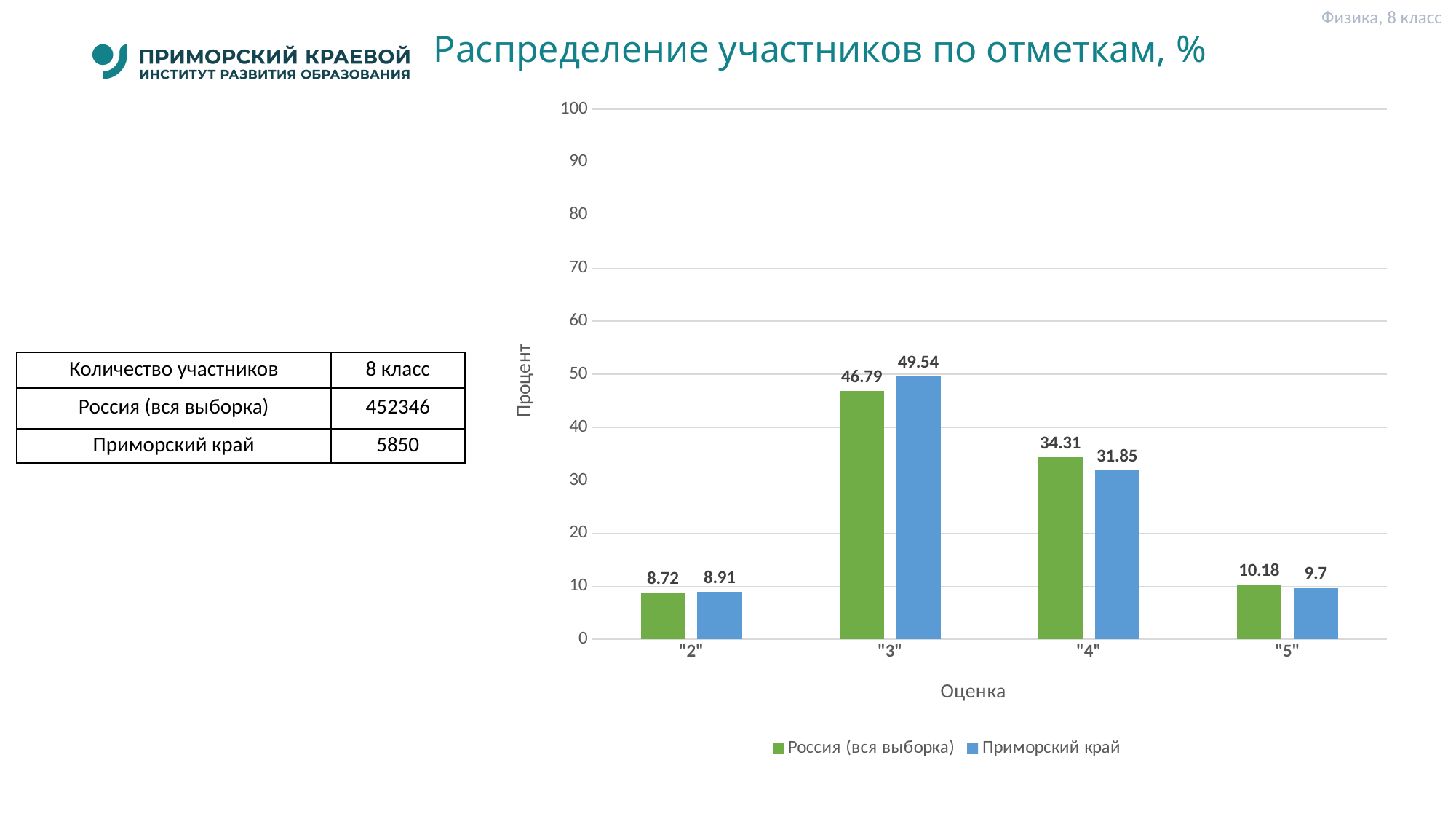
What is the value for Россия (вся выборка) for grade "2"? 8.72 What is the value for Приморский край for grade "5"? 9.7 How many grade categories are shown on the x axis? 4 What is the difference between Приморский край and Россия (вся выборка) for grade "3"? 2.75 What is the value for Россия (вся выборка) for grade "3"? 46.79 Which grade has the lowest value for Россия (вся выборка)? "2" How many series does the legend list? 2 What is the label of the y axis? Процент For grade "4", which series has the larger value: Россия (вся выборка) or Приморский край? Россия (вся выборка) What is the value for Приморский край for grade "4"? 31.85 Which grade has the highest value for Приморский край? "3" What type of chart is shown on the slide? Bar chart